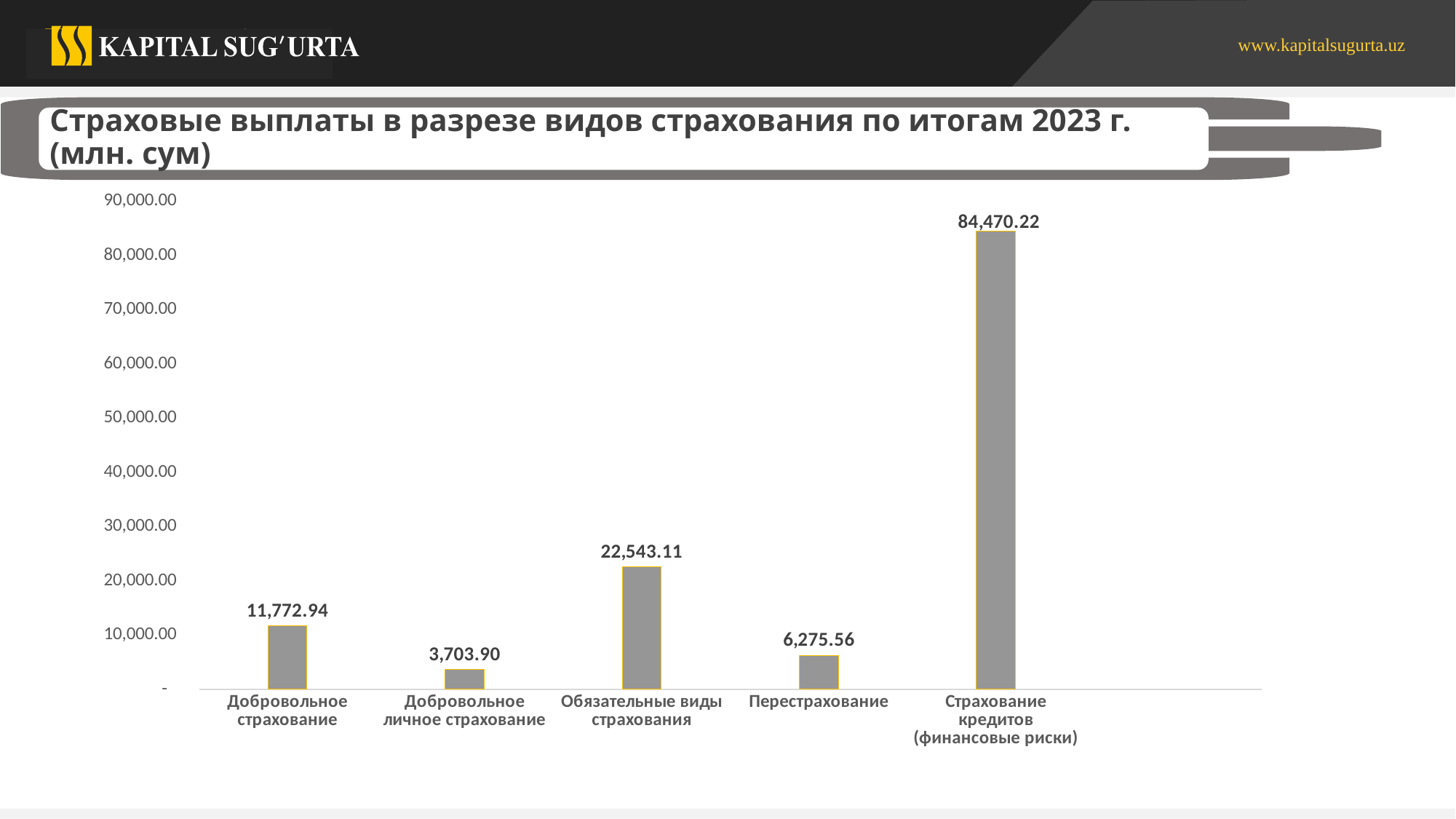
What is the value for Перестрахование? 6,275.56 Which category has the lowest value? Добровольное личное страхование How many categories are shown in the chart? 5 What is the value for Страхование кредитов (финансовые риски)? 84,470.22 What is the difference between Добровольное страхование and Добровольное личное страхование? 8,069.04 What is the value for Обязательные виды страхования? 22,543.11 Is the value for Обязательные виды страхования greater or less than 20,000.00? greater What is the value for Добровольное личное страхование? 3,703.90 What kind of chart is shown on the slide? bar chart What is the difference between Страхование кредитов (финансовые риски) and Обязательные виды страхования? 61,927.11 Which is larger, Добровольное страхование or Перестрахование? Добровольное страхование Which category has the highest value? Страхование кредитов (финансовые риски)